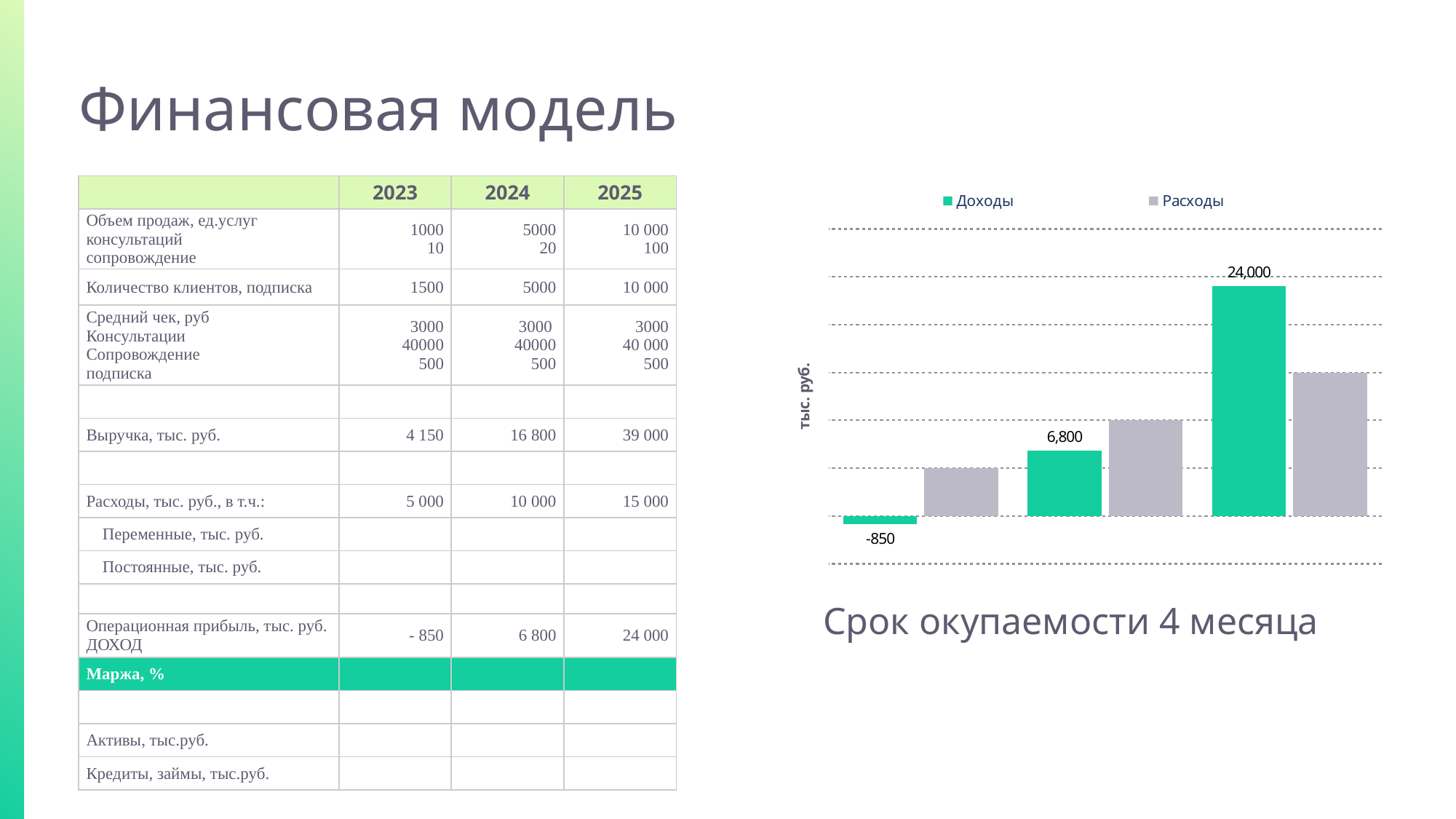
How many series does the legend of the chart list? 2 Which group has the highest Доходы value? the third (rightmost) group What is the data label on the Доходы bar in the middle group? 6,800 Do the Доходы values rise or fall from left to right across the chart? rise What are the two series named in the chart legend? Доходы and Расходы What is the label on the vertical axis of the chart? тыс. руб. Which group has the lowest Доходы value? the first (leftmost) group What is the difference between the Доходы values of the third group and the middle group? 17,200 What is the data label on the Доходы bar in the first (leftmost) group? -850 What is the data label on the Доходы bar in the third (rightmost) group? 24,000 What kind of chart is shown on the right side of the slide? bar chart How many groups of bars are plotted in the chart? 3